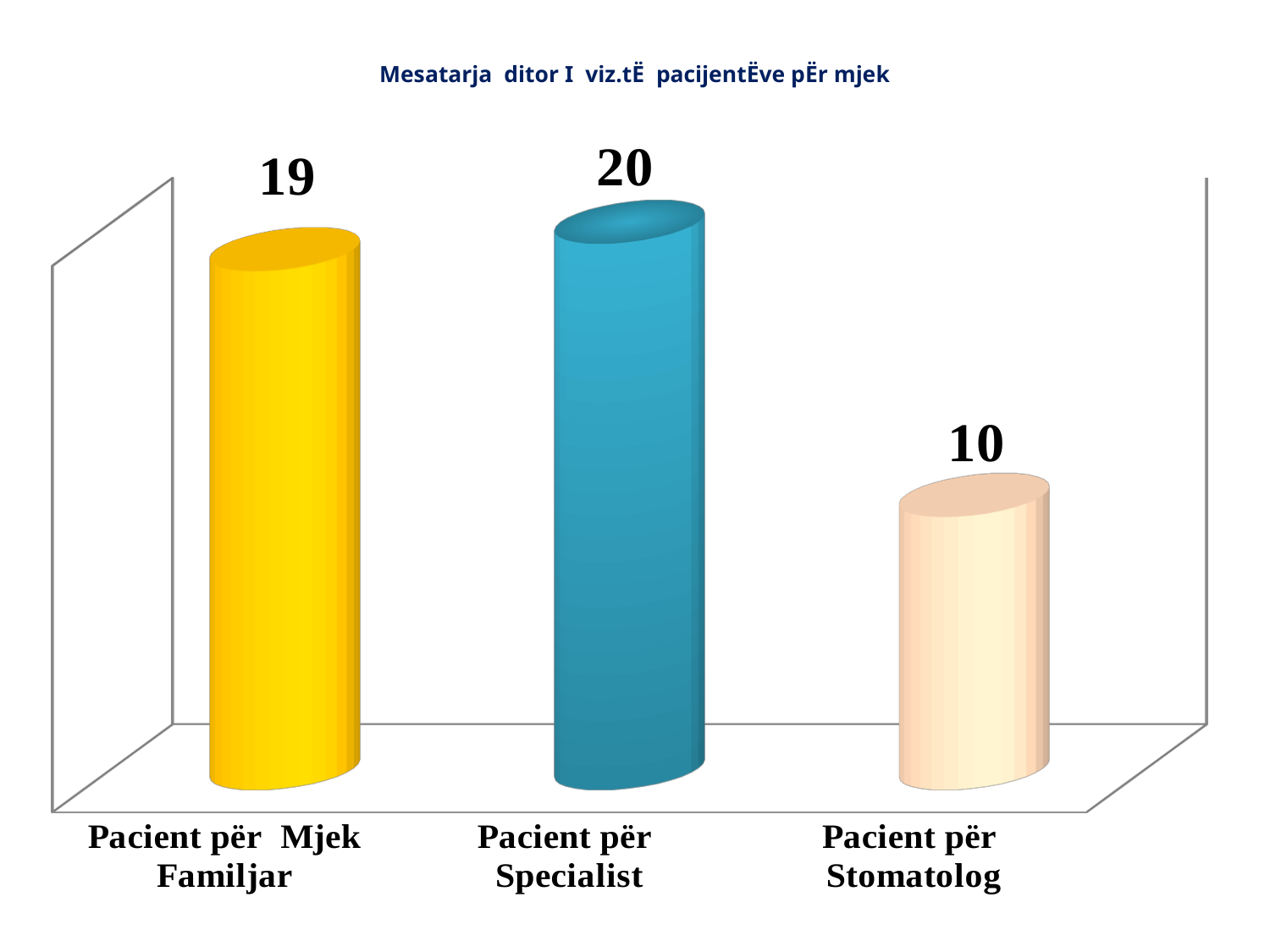
What is the value for Pacient për Specialist? 20 How many categories are shown in the chart? 3 What is the difference between the values for Pacient për Specialist and Pacient për Stomatolog? 10 What is the difference between the values for Pacient për Mjek Familjar and Pacient për Stomatolog? 9 What is the value for Pacient për Stomatolog? 10 Which category has the highest value? Pacient për Specialist What is the title of the chart? Mesatarja ditor I viz.tË pacijentËve pËr mjek What is the value for Pacient për Mjek Familjar? 19 What colour is the bar for Pacient për Specialist? Blue Which category has the lowest value? Pacient për Stomatolog Which is larger, the value for Pacient për Mjek Familjar or the value for Pacient për Stomatolog? Pacient për Mjek Familjar What kind of chart is shown on the slide? Bar chart